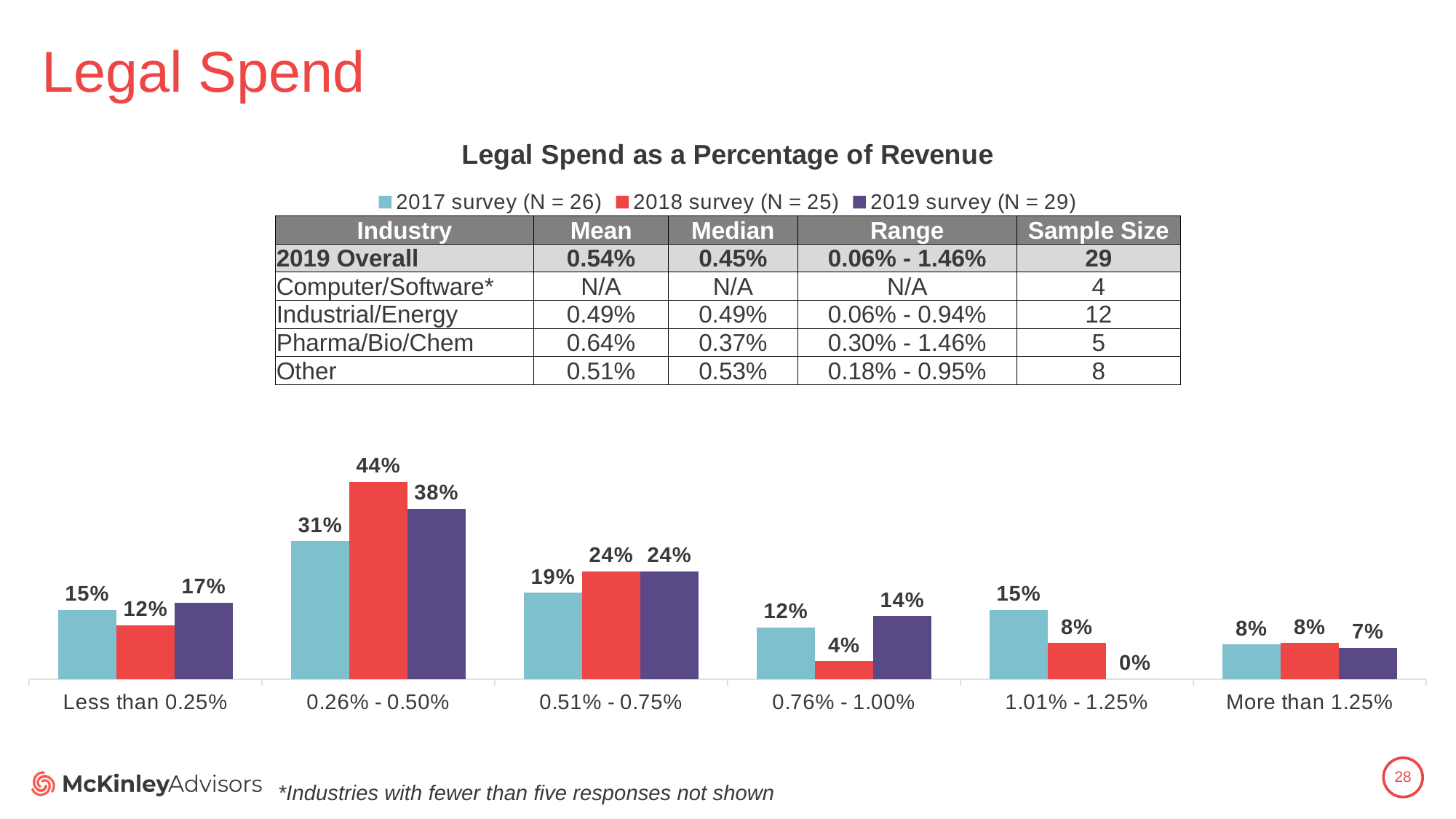
What is the value for the 2018 survey in the 0.26% - 0.50% category? 44% What is the sample size for the 2019 survey according to the legend? 29 What is the value for the 2019 survey in the 0.76% - 1.00% category? 14% How many categories are shown on the x axis of the chart? 6 What is the value for the 2017 survey in the 1.01% - 1.25% category? 15% What kind of chart is shown on the slide? Bar chart Which is larger in the Less than 0.25% category: the 2017 survey value or the 2019 survey value? 2019 survey Which category has the highest value for the 2019 survey? 0.26% - 0.50% Which category has the lowest value for the 2018 survey? 0.76% - 1.00% What is the difference between the 2018 survey and 2017 survey values in the 0.26% - 0.50% category? 13 percentage points How many series does the chart legend list? 3 What is the title of the chart? Legal Spend as a Percentage of Revenue